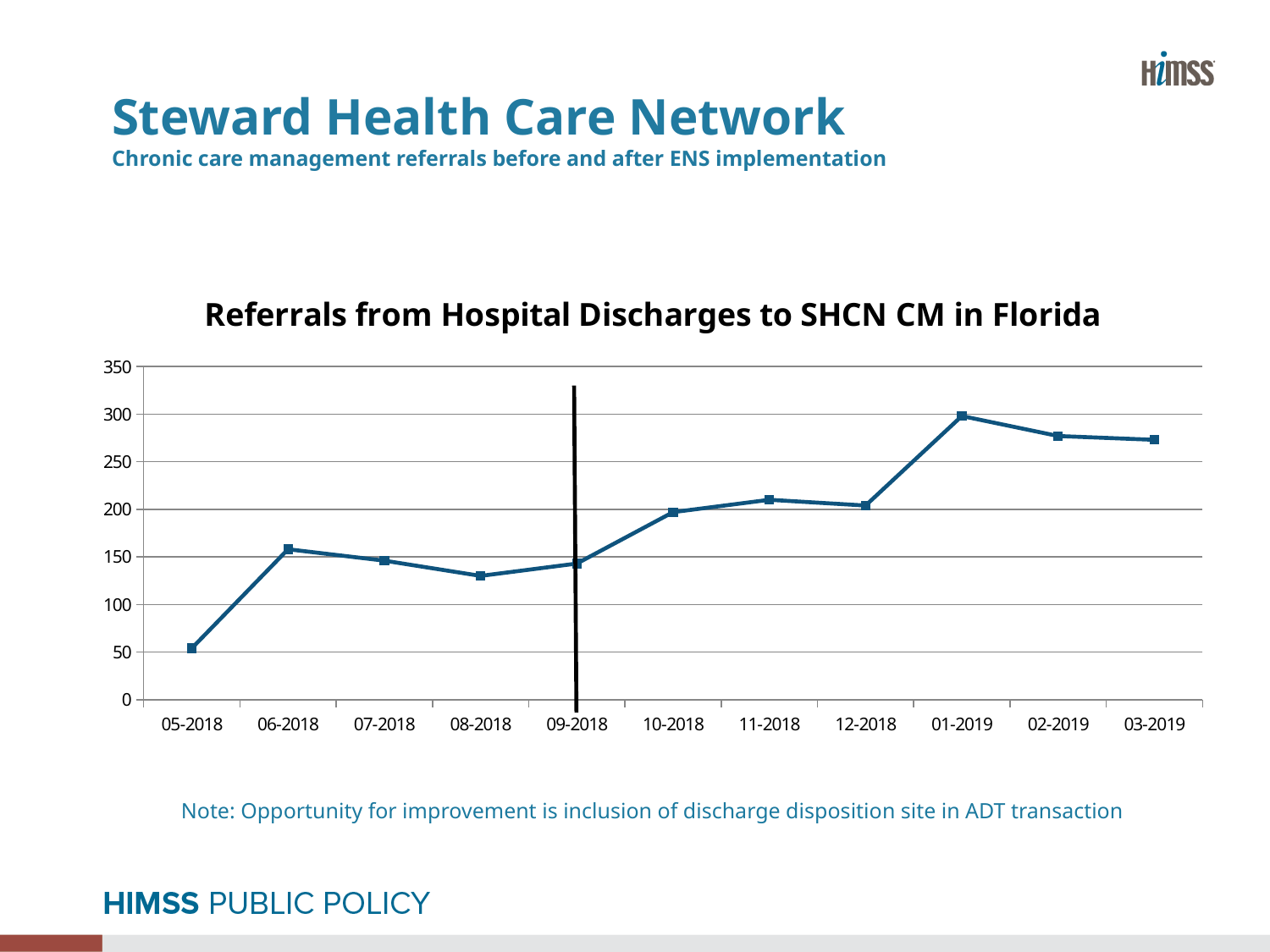
Is the value for 08-2018 greater or less than 150? less Which month has the lowest number of referrals? 05-2018 Which month has the highest number of referrals? 01-2019 Overall, do referrals rise or fall from 05-2018 to 03-2019? rise Which month has more referrals, 07-2018 or 10-2018? 10-2018 What is the title of the chart? Referrals from Hospital Discharges to SHCN CM in Florida Which month has more referrals, 06-2018 or 08-2018? 06-2018 Is the value for 02-2019 greater or less than 250? greater What kind of chart is shown on the slide? line chart Is the value for 01-2019 greater or less than 250? greater How many monthly data points are plotted on the chart? 11